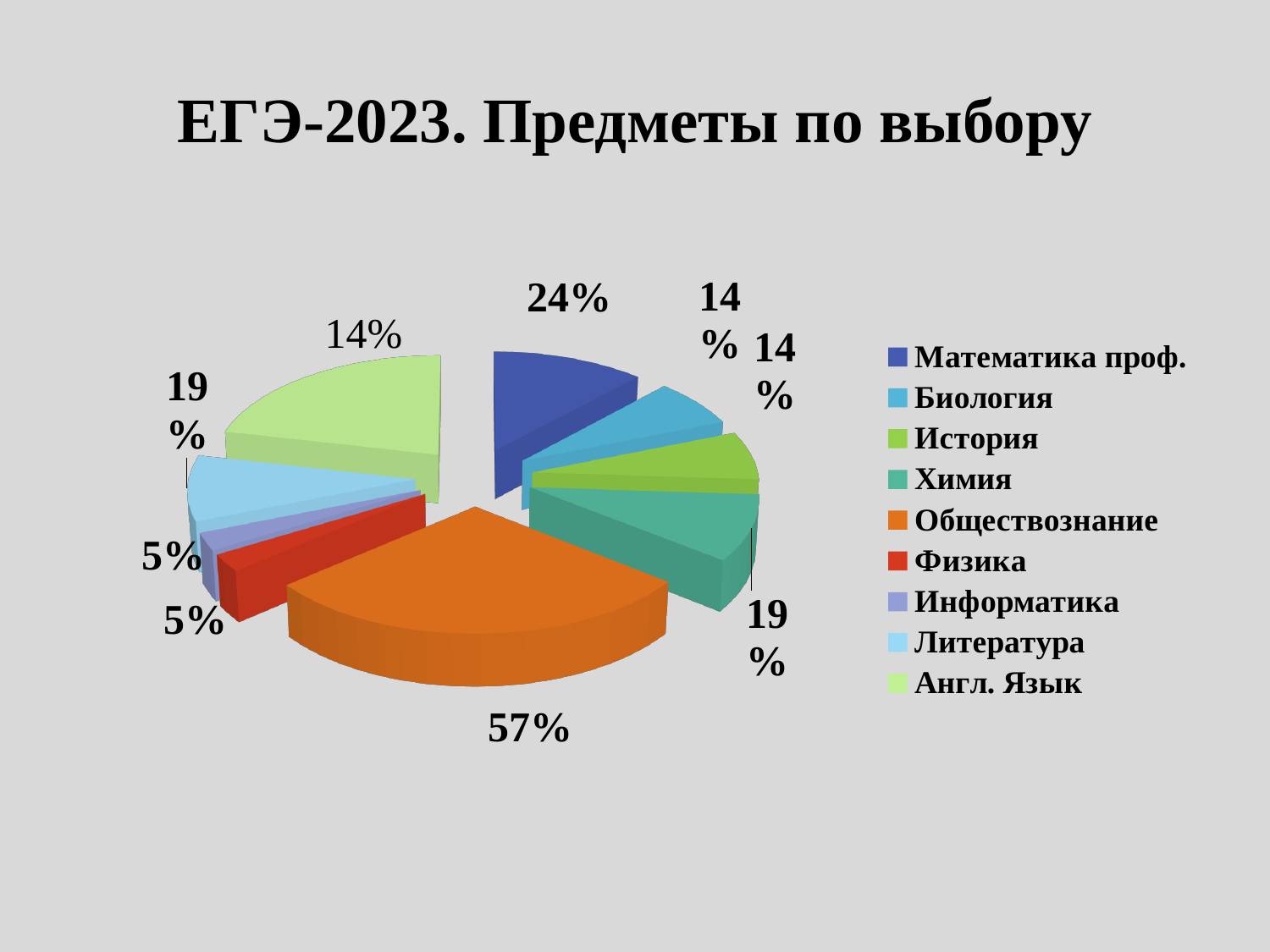
What percentage is shown for Химия? 19% What is the difference in percentage points between Обществознание and Математика проф.? 33 How many subjects (categories) does the legend list? 9 What percentage is shown for Обществознание? 57% Which has a larger value, Математика проф. or Биология? Математика проф. What is the title of the chart on the slide? ЕГЭ-2023. Предметы по выбору What percentage is shown for Математика проф.? 24% Which subject has the largest slice of the pie? Обществознание What percentage is shown for Физика? 5% Which colour represents Обществознание in the chart? Orange What type of chart is shown on the slide? Pie chart What percentage is shown for Англ. Язык? 14%